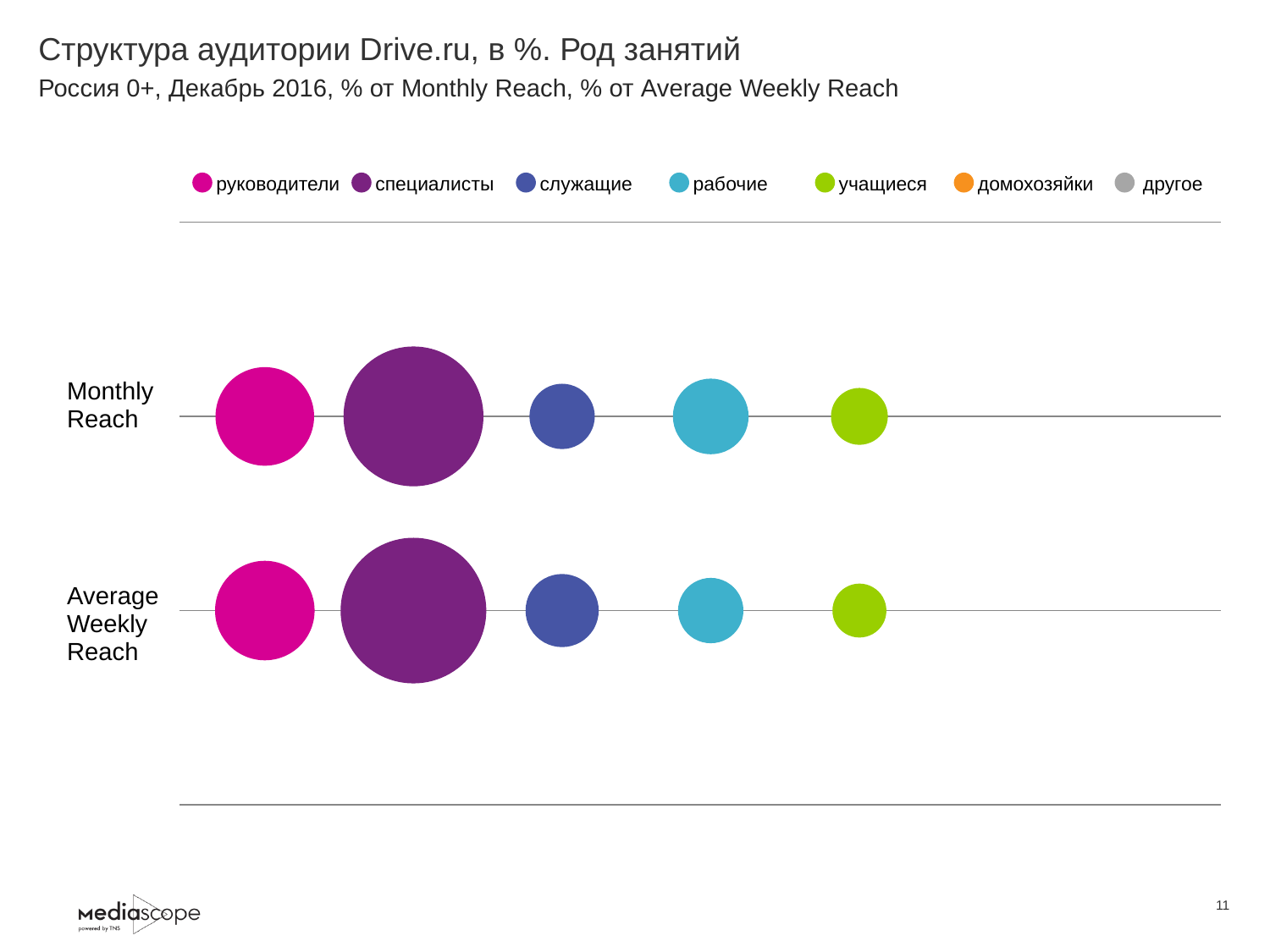
Which occupation group has the largest bubble in the Monthly Reach row? специалисты How many series does the legend list? 7 What kind of chart is shown on the slide? bubble chart How many rows (reach categories) are plotted on the chart? 2 Which visible occupation group has the smallest bubble in the Monthly Reach row? учащиеся What colour is the bubble for специалисты? purple What is the title of the chart on the slide? Структура аудитории Drive.ru, в %. Род занятий In the Monthly Reach row, which bubble is larger: руководители or служащие? руководители Which occupation group has the largest bubble in the Average Weekly Reach row? специалисты In the Average Weekly Reach row, which bubble is larger: специалисты or рабочие? специалисты